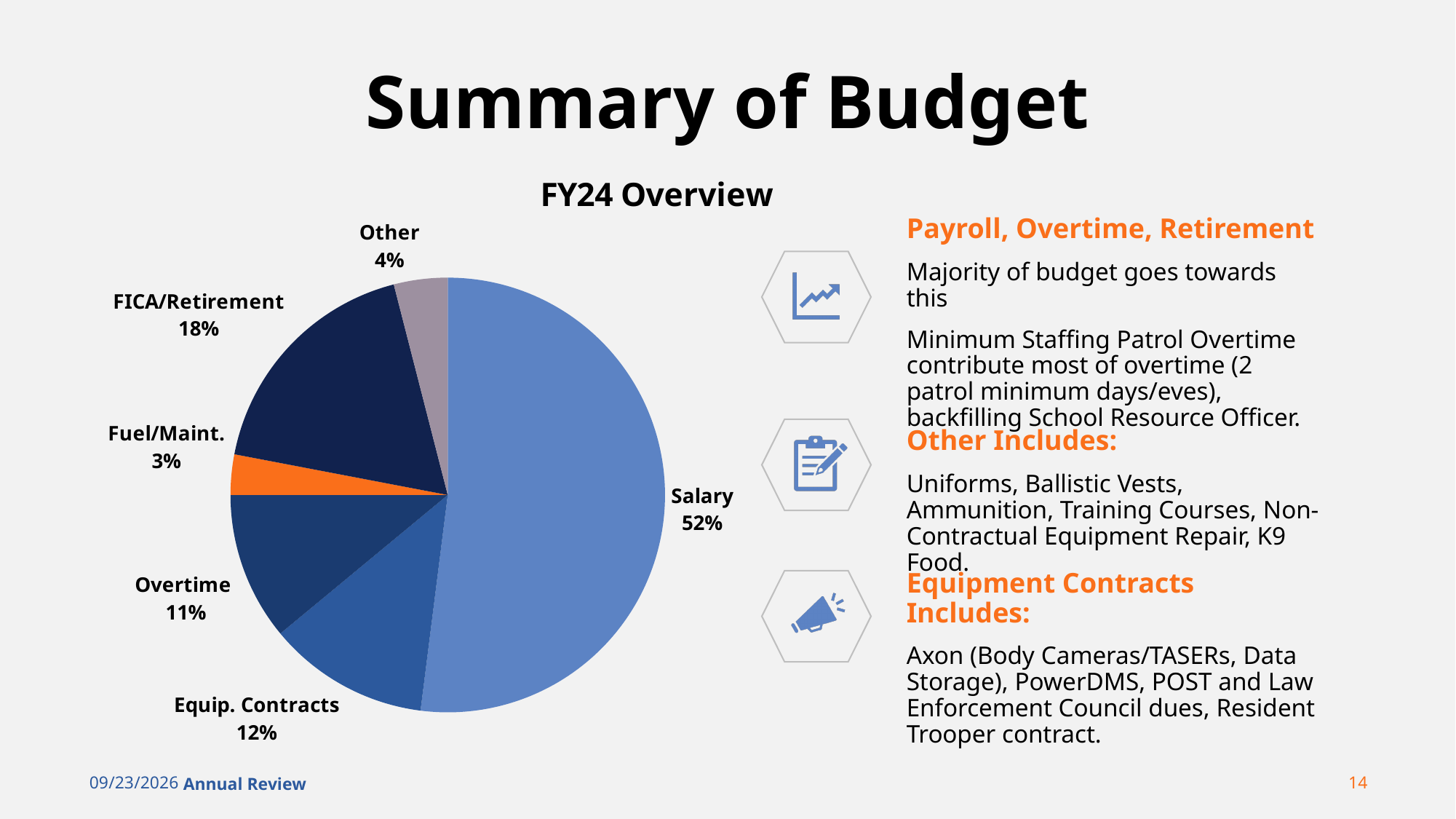
What is the difference in percentage points between Other and Fuel/Maint.? 1 Which category has the largest slice in the FY24 Overview pie? Salary How many categories are shown in the FY24 Overview pie chart? 6 Which category has the smallest slice in the FY24 Overview pie? Fuel/Maint. What is the difference in percentage points between Salary and FICA/Retirement? 34 What share of the FY24 Overview pie does Salary account for? 52% What percentage is shown for Overtime? 11% What kind of chart is shown on the slide? Pie chart What percentage is shown for Equip. Contracts? 12% What is the value shown for FICA/Retirement in the FY24 Overview chart? 18% Which is larger, the Overtime slice or the Equip. Contracts slice? Equip. Contracts What is the title of the chart on the slide? FY24 Overview